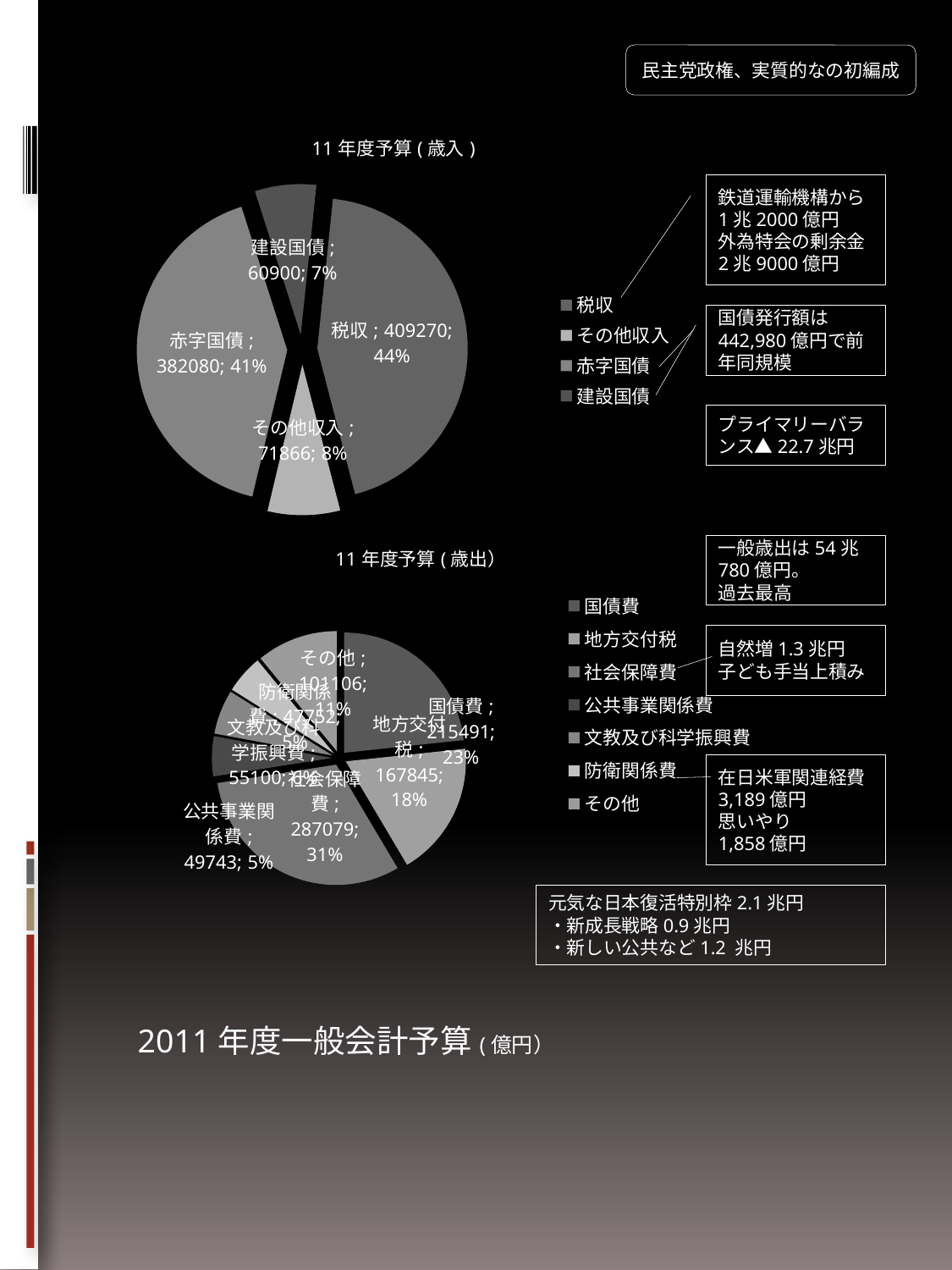
How many categories does the 11年度予算(歳出) chart have? 7 In the 11年度予算(歳入) chart, what is the value for 税収? 409270 In the 11年度予算(歳出) chart, what share of the pie is 国債費? 23% What type of chart is the 11年度予算(歳出) chart? Pie chart How many entries does the legend of the 11年度予算(歳入) chart list? 4 In the 11年度予算(歳入) chart, which category is the smallest? 建設国債 In the 11年度予算(歳出) chart, what is the difference between 社会保障費 and 国債費? 71588 In the 11年度予算(歳出) chart, what is the value for 社会保障費? 287079 In the 11年度予算(歳出) chart, which is larger, 国債費 or 地方交付税? 国債費 In the 11年度予算(歳入) chart, which category is the largest? 税収 In the 11年度予算(歳入) chart, what is the difference between 税収 and 赤字国債? 27190 In the 11年度予算(歳入) chart, what share of the pie is 赤字国債? 41%